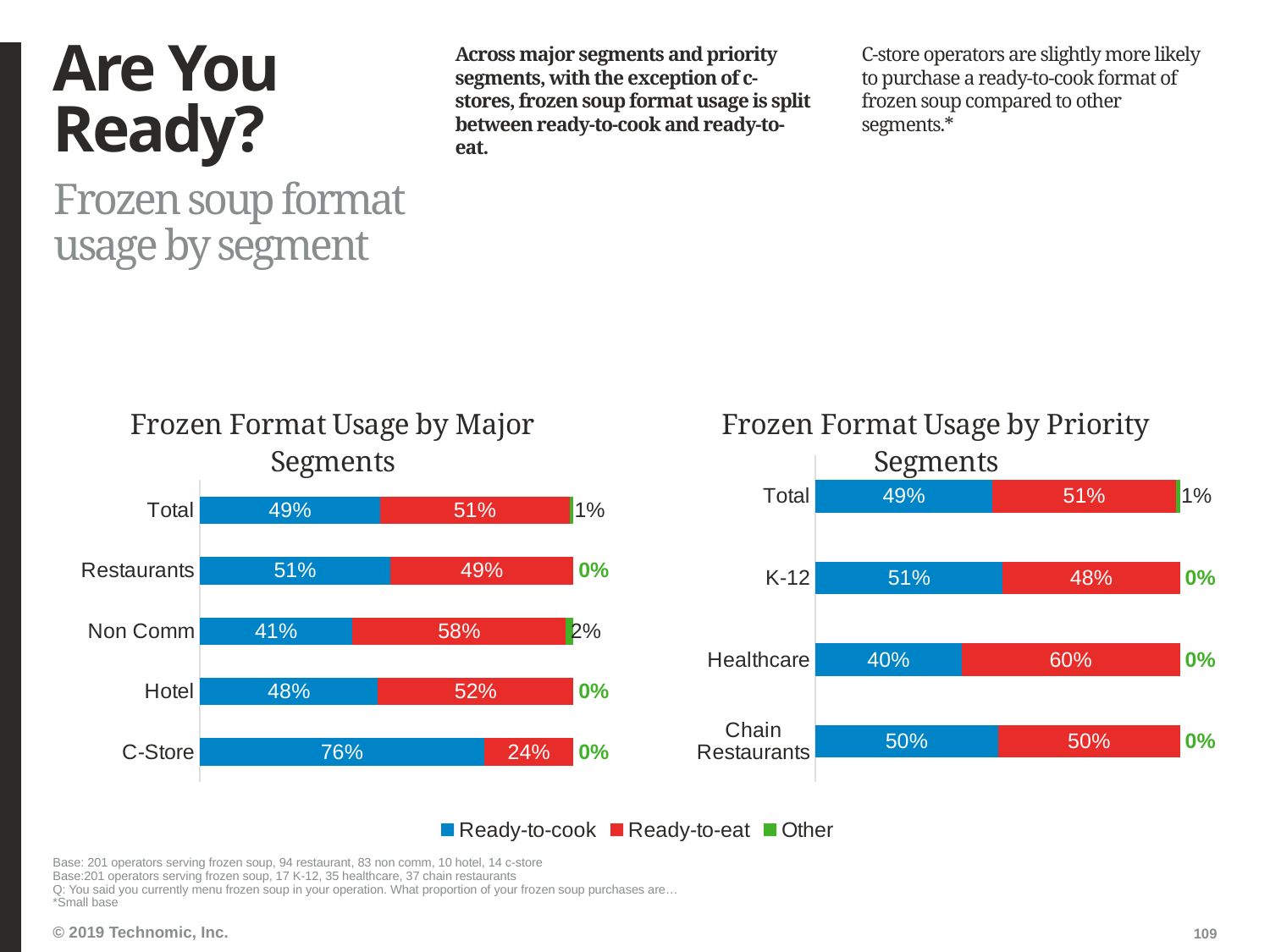
In the 'Frozen Format Usage by Priority Segments' chart, what is the Ready-to-eat value for Healthcare? 60% In the 'Frozen Format Usage by Major Segments' chart, which segment has the highest Ready-to-cook value? C-Store What kind of chart is 'Frozen Format Usage by Priority Segments'? Stacked bar chart In the 'Frozen Format Usage by Major Segments' chart, what is the Ready-to-eat value for Non Comm? 58% In the 'Frozen Format Usage by Major Segments' chart, what is the Ready-to-cook value for C-Store? 76% How many series does the legend list? 3 In the 'Frozen Format Usage by Major Segments' chart, what is the Other value for Non Comm? 2% How many segments are shown in the 'Frozen Format Usage by Major Segments' chart? 5 In the 'Frozen Format Usage by Major Segments' chart, what is the difference between the Ready-to-cook and Ready-to-eat values for C-Store? 52% In the 'Frozen Format Usage by Priority Segments' chart, what is the Ready-to-cook value for K-12? 51% In the 'Frozen Format Usage by Priority Segments' chart, is the Ready-to-eat value for Healthcare larger than the Ready-to-eat value for K-12? Yes In the 'Frozen Format Usage by Priority Segments' chart, which segment has the lowest Ready-to-cook value? Healthcare